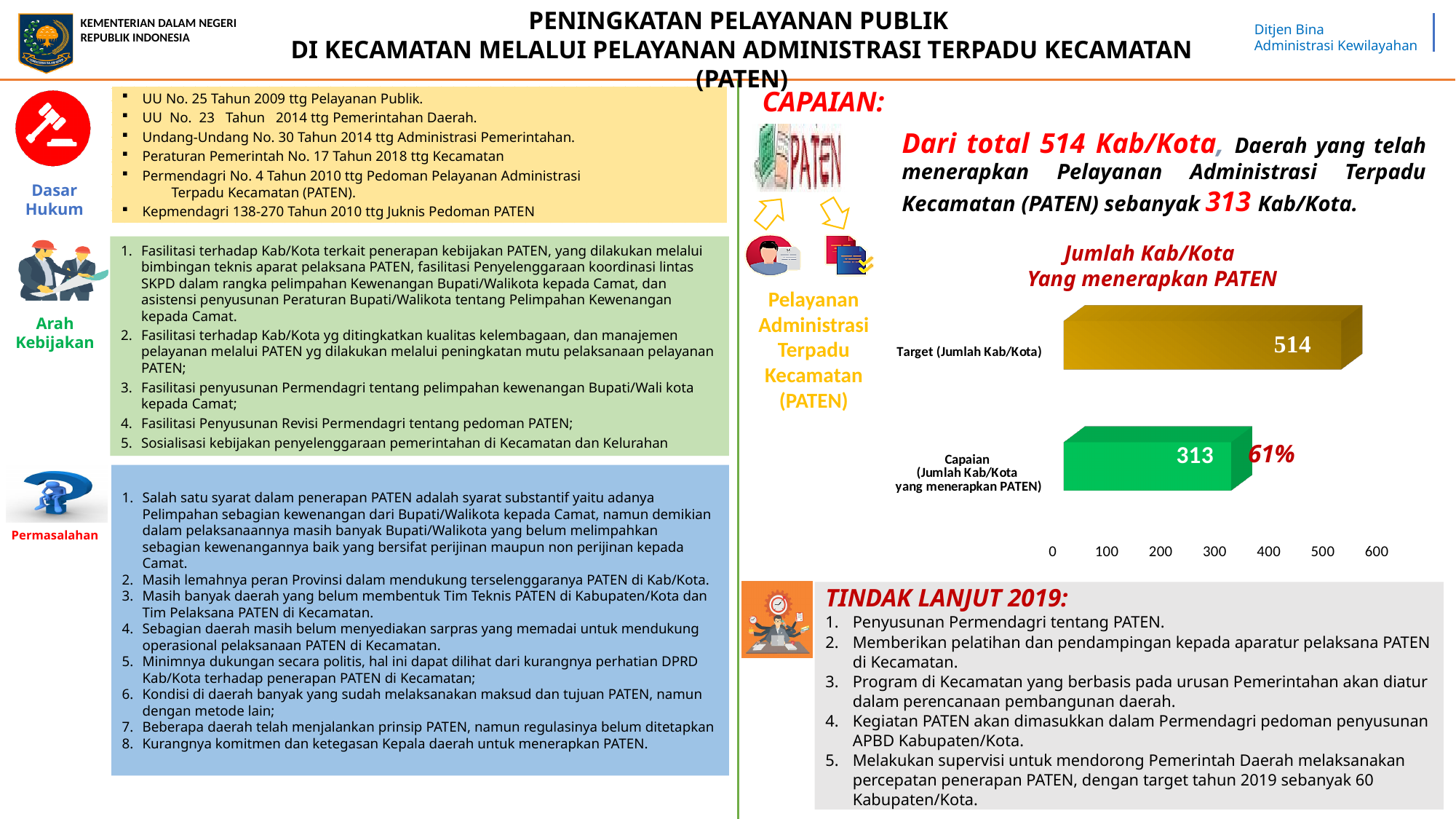
Is the value for Target in the chart greater or less than 500? greater What is the title of the chart on the slide? Jumlah Kab/Kota Yang menerapkan PATEN What is the difference between the Target bar and the Capaian bar in the chart? 201 Which is larger in the chart, the Target bar or the Capaian bar? Target (Jumlah Kab/Kota) What kind of chart is shown on the slide? Bar chart What is the value of the Target (Jumlah Kab/Kota) bar in the chart? 514 What is the value of the Capaian (Jumlah Kab/Kota yang menerapkan PATEN) bar in the chart? 313 Is the value for Capaian in the chart greater or less than 400? less Which bar in the chart is the lowest? Capaian (Jumlah Kab/Kota yang menerapkan PATEN) What percentage is printed next to the Capaian bar in the chart? 61% Which bar in the chart is the highest? Target (Jumlah Kab/Kota) How many bars are plotted in the chart? 2